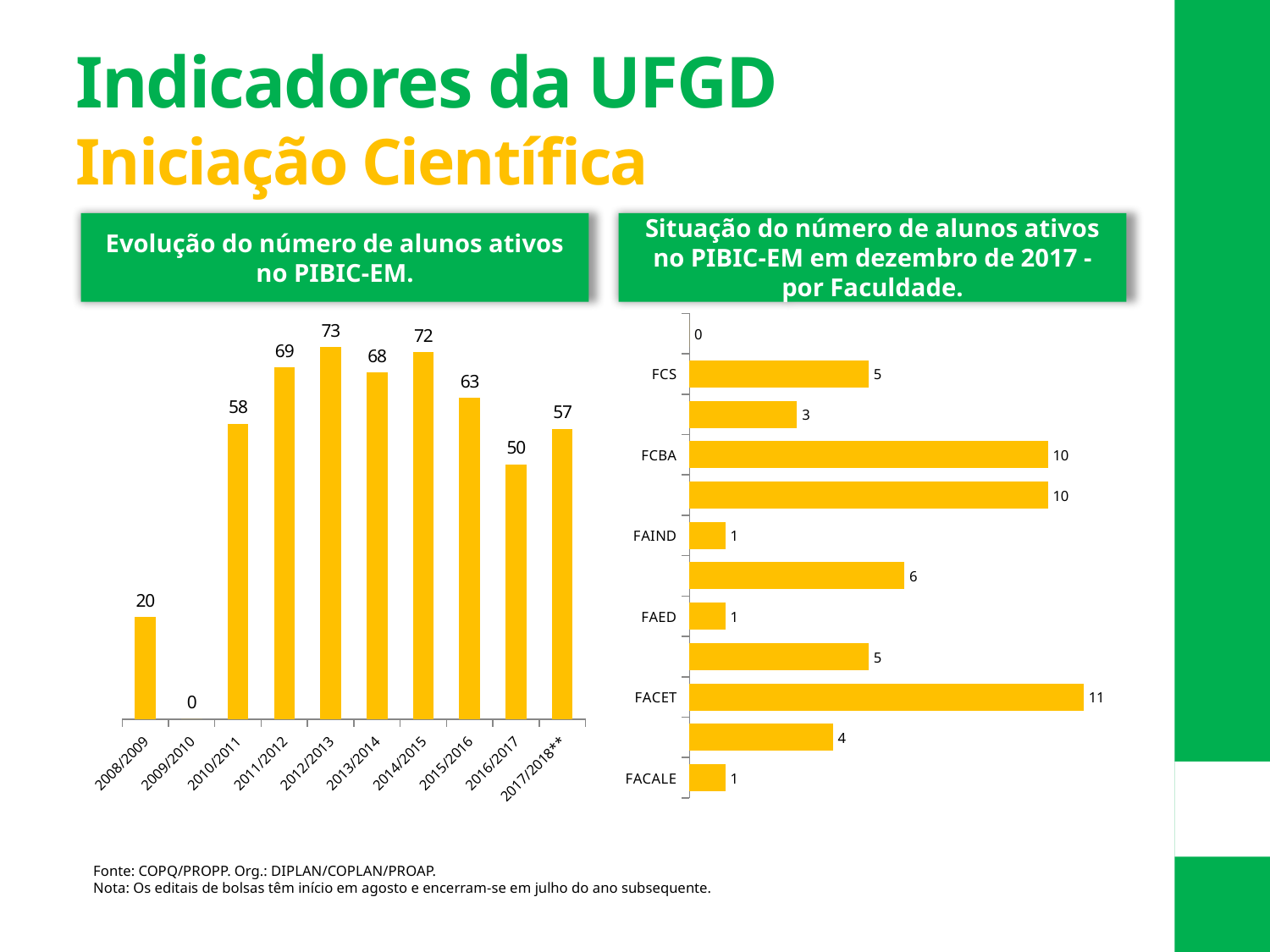
In the chart 'Situação do número de alunos ativos no PIBIC-EM em dezembro de 2017 - por Faculdade', what is the value for FACET? 11 In the chart 'Evolução do número de alunos ativos no PIBIC-EM', which is larger: the value for 2011/2012 or the value for 2015/2016? 2011/2012 In the chart 'Evolução do número de alunos ativos no PIBIC-EM', which year has the lowest value? 2009/2010 In the chart 'Situação do número de alunos ativos no PIBIC-EM em dezembro de 2017 - por Faculdade', which labelled faculty has the highest value? FACET In the chart 'Evolução do número de alunos ativos no PIBIC-EM', what is the difference between the values for 2014/2015 and 2016/2017? 22 In the chart 'Evolução do número de alunos ativos no PIBIC-EM', how many years are shown on the x axis? 10 In the chart 'Evolução do número de alunos ativos no PIBIC-EM', what is the value for 2017/2018**? 57 In the chart 'Evolução do número de alunos ativos no PIBIC-EM', which year has the highest value? 2012/2013 In the chart 'Situação do número de alunos ativos no PIBIC-EM em dezembro de 2017 - por Faculdade', what is the value for FCBA? 10 In the chart 'Evolução do número de alunos ativos no PIBIC-EM', what is the value for 2012/2013? 73 In the chart 'Evolução do número de alunos ativos no PIBIC-EM', do the values rise or fall from 2014/2015 to 2016/2017? fall What kind of chart is the chart on the right of the slide? bar chart